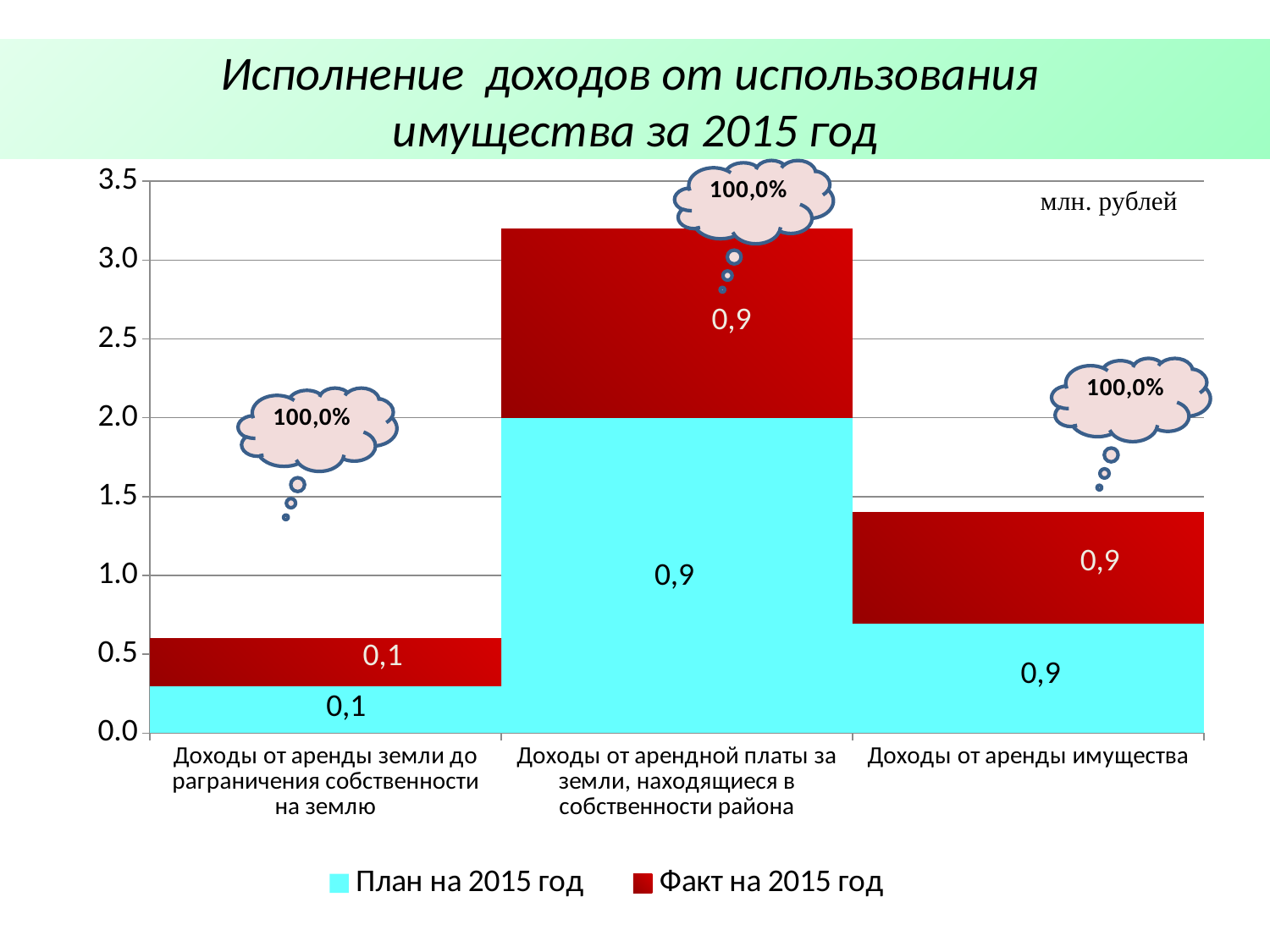
What kind of chart is shown on the slide? stacked bar chart How many categories are shown on the x axis of the chart? 3 Which category has the shortest stacked bar? Доходы от аренды земли до разграничения собственности на землю Which category has the tallest stacked bar? Доходы от арендной платы за земли, находящиеся в собственности района What are the two series named in the legend? План на 2015 год, Факт на 2015 год How many series does the chart legend list? 2 Is the top of the stacked bar for 'Доходы от арендной платы за земли, находящиеся в собственности района' greater or less than 3.0? greater What percentage is shown in the cloud callout above the 'Доходы от аренды имущества' bar? 100,0% What is the data label for 'План на 2015 год' in the category 'Доходы от аренды земли до разграничения собственности на землю'? 0,1 What is the data label for 'Факт на 2015 год' in the category 'Доходы от аренды земли до разграничения собственности на землю'? 0,1 What is the data label for 'Факт на 2015 год' in the category 'Доходы от арендной платы за земли, находящиеся в собственности района'? 0,9 What is the data label for 'План на 2015 год' in the category 'Доходы от аренды имущества'? 0,9